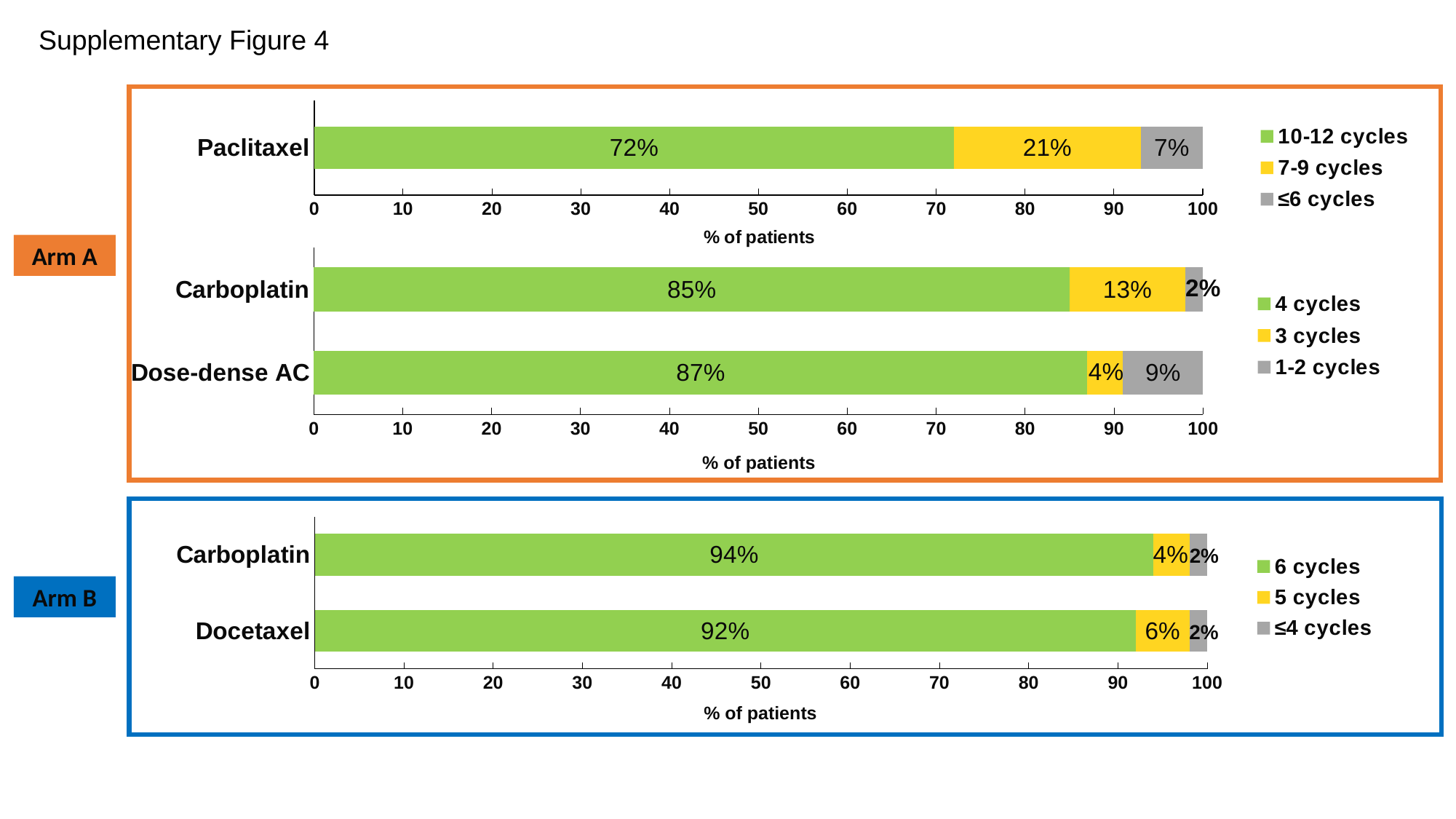
In the Arm B chart, what percentage of Carboplatin patients received 5 cycles? 4% In the Arm B chart, what is the difference between the 6 cycles percentage for Carboplatin and for Docetaxel? 2% In the Arm A Carboplatin and Dose-dense AC chart, what percentage of Dose-dense AC patients received 1-2 cycles? 9% In the Arm B chart, which drug has the higher percentage of patients receiving 6 cycles, Carboplatin or Docetaxel? Carboplatin What type of chart is used in the Arm B panel? Stacked bar chart In the Arm A Carboplatin and Dose-dense AC chart, what is the difference between the 3 cycles percentage for Carboplatin and for Dose-dense AC? 9% What is the x-axis title of the Arm B chart? % of patients In the Arm B chart, what percentage of Docetaxel patients received 6 cycles? 92% In the Arm A Paclitaxel chart, what percentage of patients received 10-12 cycles? 72% How many series does the legend of the Arm B chart list? 3 In the Arm A Carboplatin and Dose-dense AC chart, what percentage of Carboplatin patients received 4 cycles? 85% In the Arm A Paclitaxel chart, what percentage of patients received 7-9 cycles? 21%